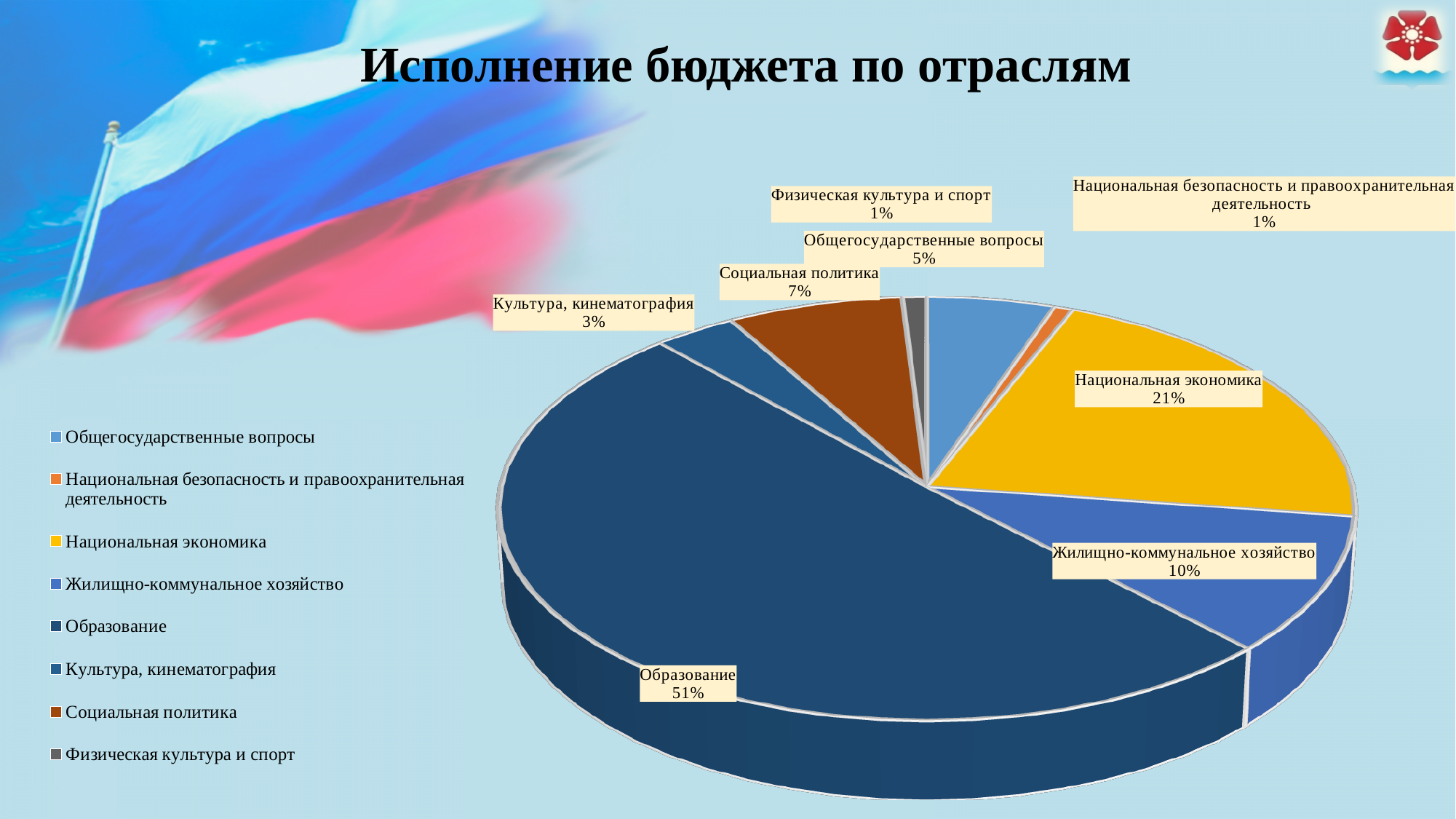
What is the value shown for Жилищно-коммунальное хозяйство? 10% What is the value shown for Национальная экономика? 21% Which is larger, the share of Социальная политика or the share of Общегосударственные вопросы? Социальная политика What kind of chart is shown on the slide? Pie chart What is the title of the chart on the slide? Исполнение бюджета по отраслям How many categories does the pie chart show? 8 What is the value shown for Культура, кинематография? 3% What is the value shown for Социальная политика? 7% Which category has the largest slice of the pie? Образование What colour is the slice for Национальная экономика? Yellow What share of the pie does Образование have? 51% What is the difference between the shares of Национальная экономика and Жилищно-коммунальное хозяйство? 11%